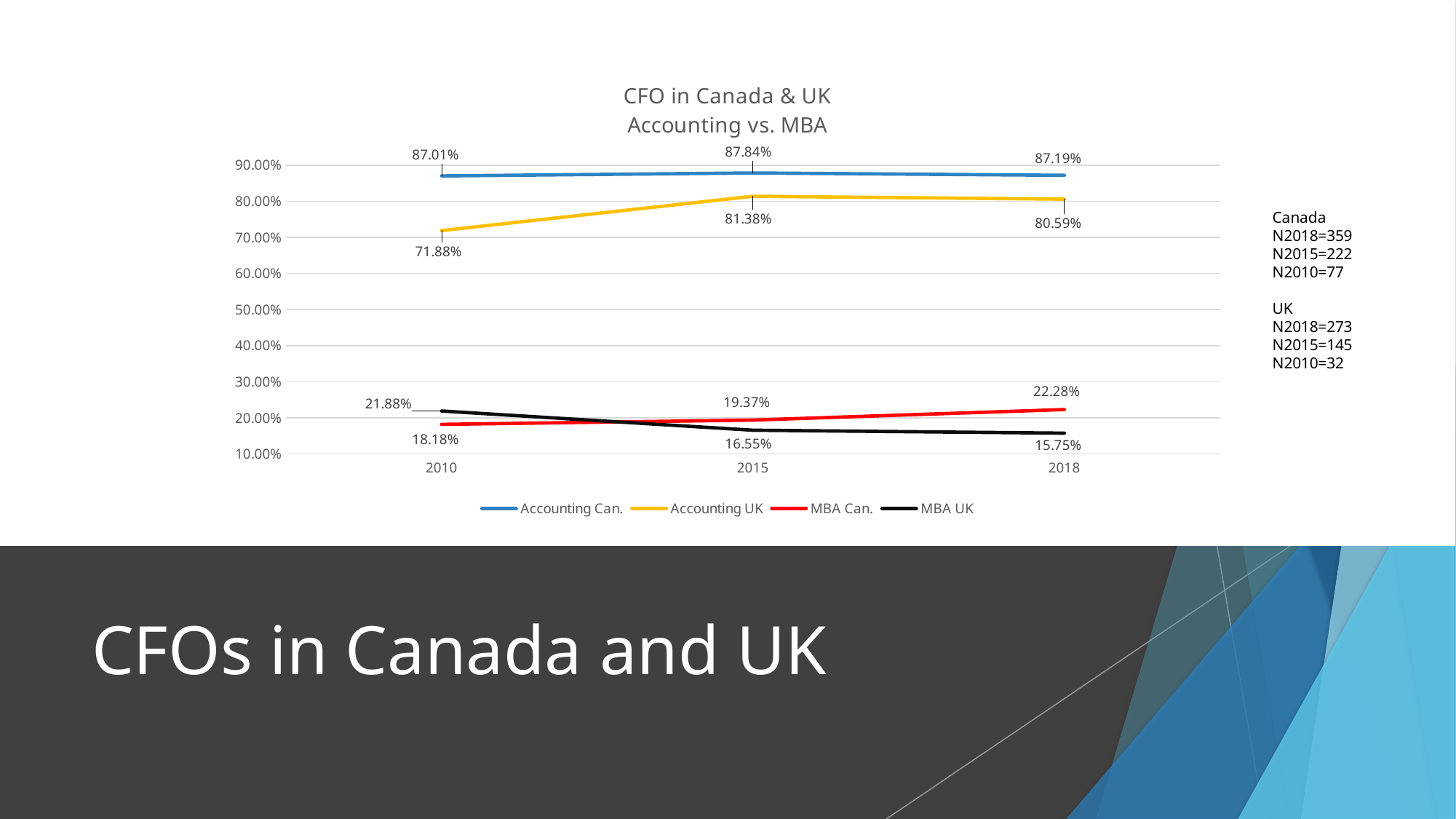
In which year is the Accounting UK value highest? 2015 In which year is the MBA UK value lowest? 2018 What is the value for Accounting Can. in 2015? 87.84% What is the title of the chart? CFO in Canada & UK Accounting vs. MBA What is the value for MBA Can. in 2018? 22.28% What is the value for Accounting UK in 2010? 71.88% How many series does the legend list? 4 Which is larger in 2010, MBA Can. or MBA UK? MBA UK How many years are shown on the x axis? 3 Does the MBA UK series rise or fall from 2010 to 2018? fall What type of chart is shown on the slide? line chart What is the difference between Accounting UK in 2015 and in 2010? 9.50%